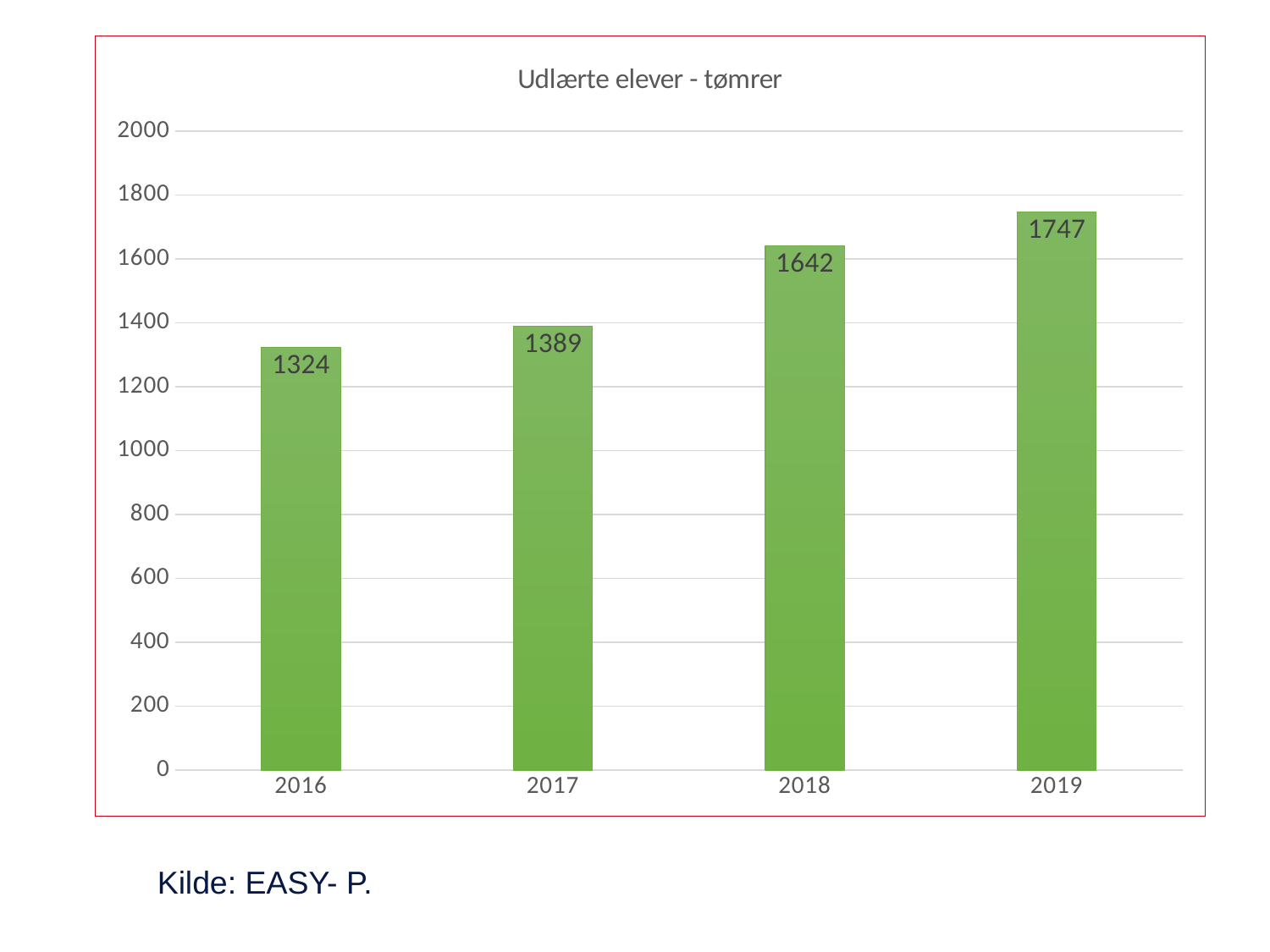
What is the value for 2017? 1389 What is the difference between the values for 2018 and 2017? 253 How many years are shown on the x axis? 4 What kind of chart is shown? bar chart What is the difference between the values for 2019 and 2016? 423 Which is larger, the value for 2017 or the value for 2018? 2018 Which year has the lowest value? 2016 What is the value for 2019? 1747 What is the value for 2018? 1642 What is the value for 2016? 1324 Which year has the highest value? 2019 Is the value for 2019 greater or less than 1600? greater